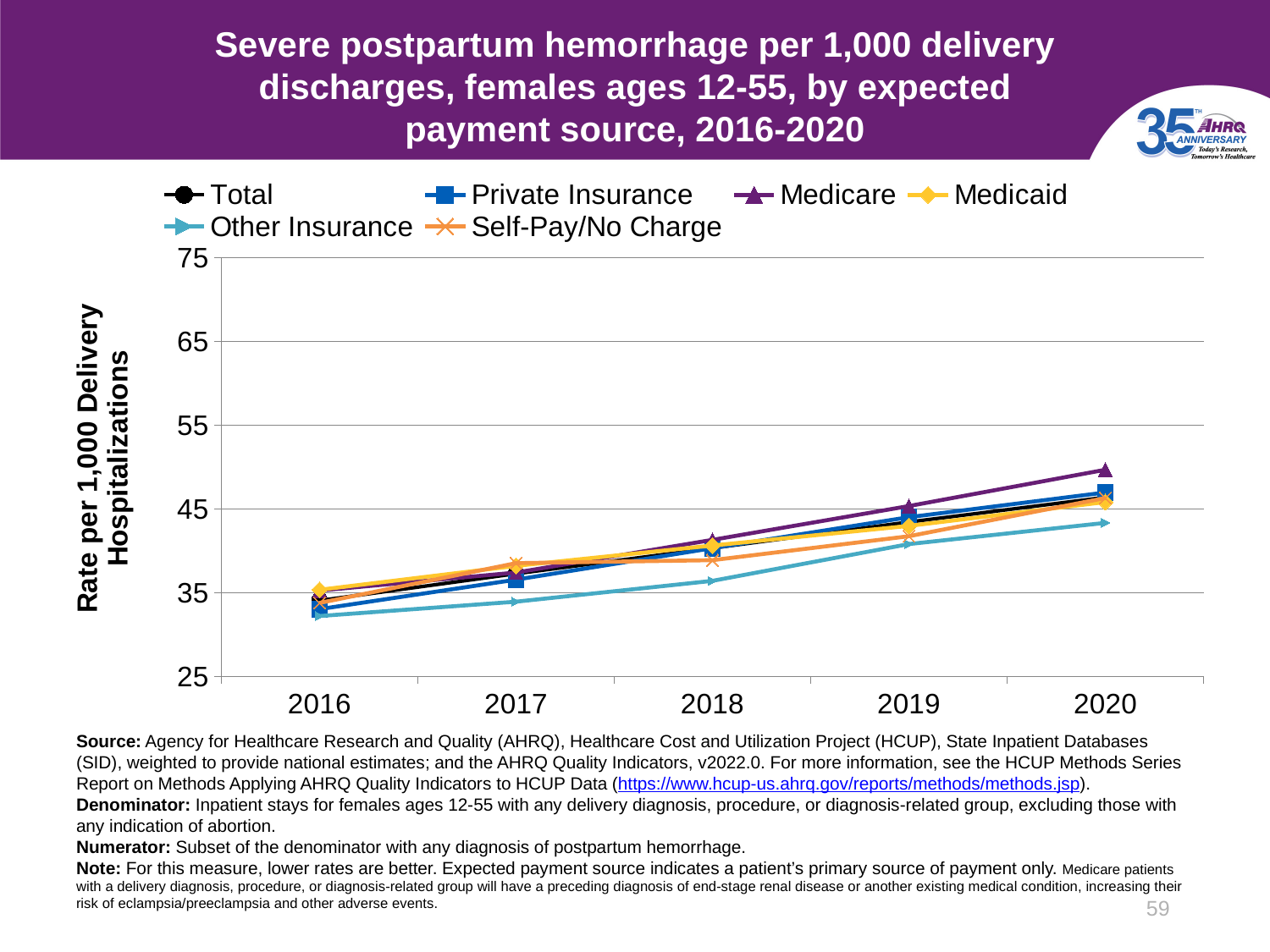
Which series is drawn with a black line and circle markers? Total Is the value for Medicare in 2020 greater or less than 45? greater Is the value for Other Insurance in 2016 greater or less than 35? less Which payment source has the highest rate in 2020? Medicare Does the Total rate rise or fall from 2016 to 2020? Rise In 2018, which is larger: the rate for Medicare or the rate for Other Insurance? Medicare How many years are plotted along the x axis? 5 Which payment source has the lowest rate in 2020? Other Insurance Is the value for Other Insurance in 2020 greater or less than 45? less What is the label on the y axis? Rate per 1,000 Delivery Hospitalizations What kind of chart is shown on the slide? Line chart How many series does the legend list? 6